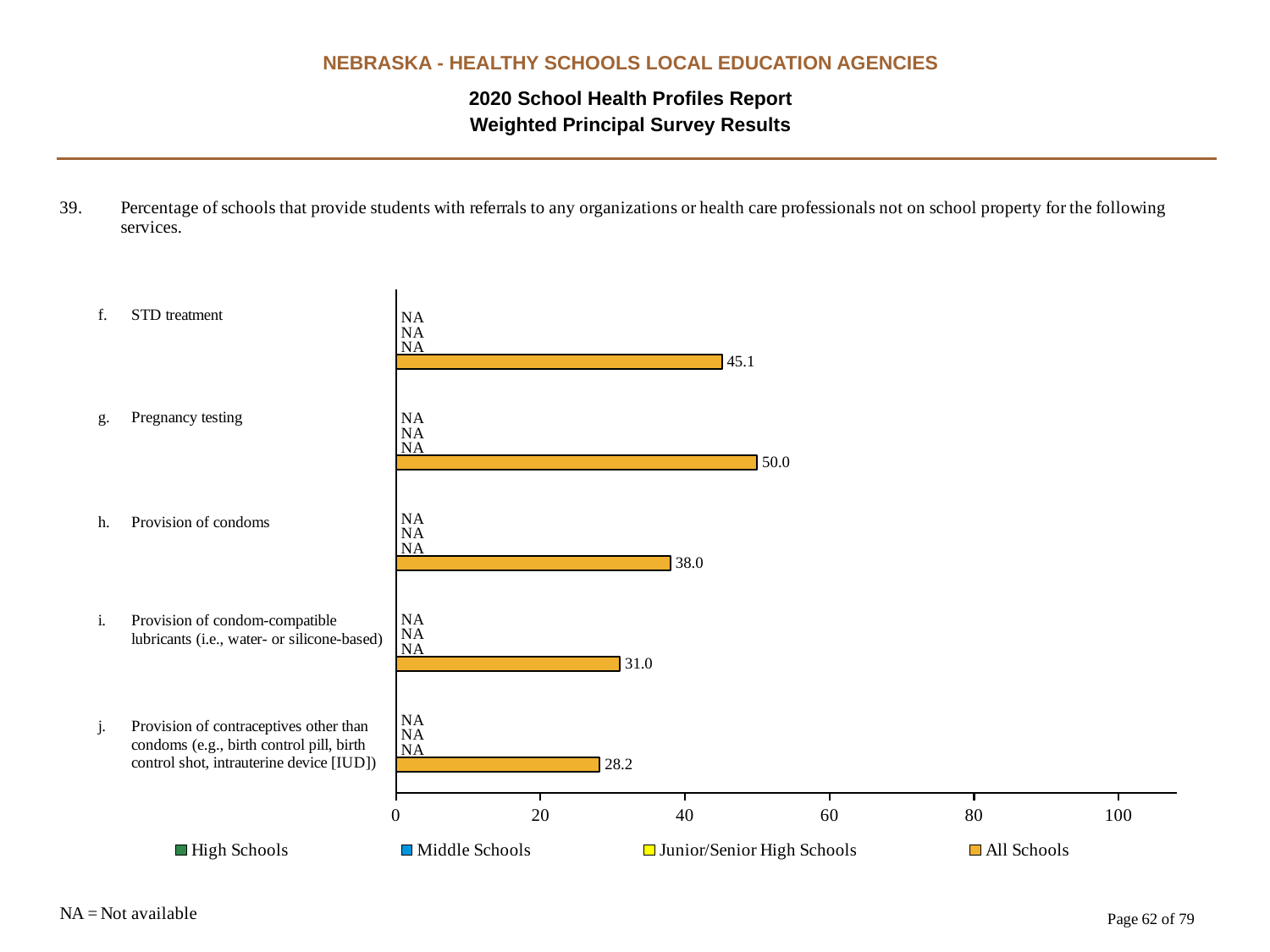
What kind of chart is shown on the slide? Bar chart What is the All Schools value for Provision of contraceptives other than condoms? 28.2 Which service has the highest All Schools value? Pregnancy testing Which has a larger All Schools value: STD treatment or Provision of condoms? STD treatment How many services (categories) are shown on the chart? 5 What is the All Schools value for Provision of condoms? 38.0 What is the All Schools value for Pregnancy testing? 50.0 What is the difference between the All Schools values for Pregnancy testing and Provision of condom-compatible lubricants? 19.0 How many series does the legend list? 4 What value is shown for High Schools for STD treatment? NA What is the All Schools value for STD treatment? 45.1 Which service has the lowest All Schools value? Provision of contraceptives other than condoms